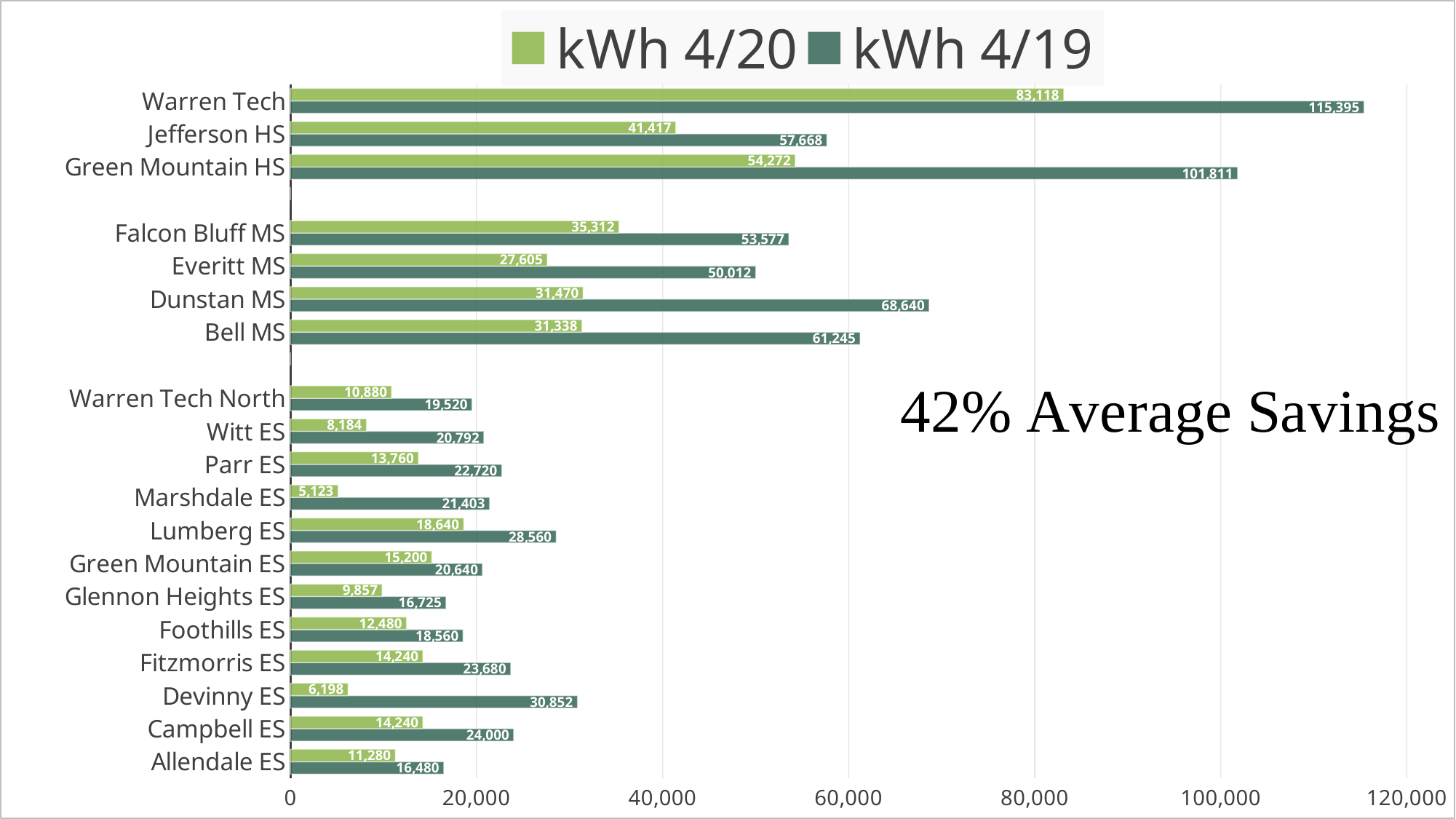
What is the difference between the kWh 4/19 and kWh 4/20 values for Warren Tech? 32,277 How many series does the legend list? 2 Which school has the lowest kWh 4/20 value? Marshdale ES What is the kWh 4/19 value for Warren Tech? 115,395 What is the difference between the kWh 4/19 and kWh 4/20 values for Dunstan MS? 37,170 Which has the larger kWh 4/19 value, Devinny ES or Witt ES? Devinny ES What is the kWh 4/20 value for Marshdale ES? 5,123 What average savings percentage is stated in the text on the chart? 42% What is the kWh 4/19 value for Campbell ES? 24,000 Which school has the highest kWh 4/19 value? Warren Tech Is the kWh 4/19 value for Green Mountain HS greater or less than 100,000? greater What kind of chart is shown on the slide? bar chart